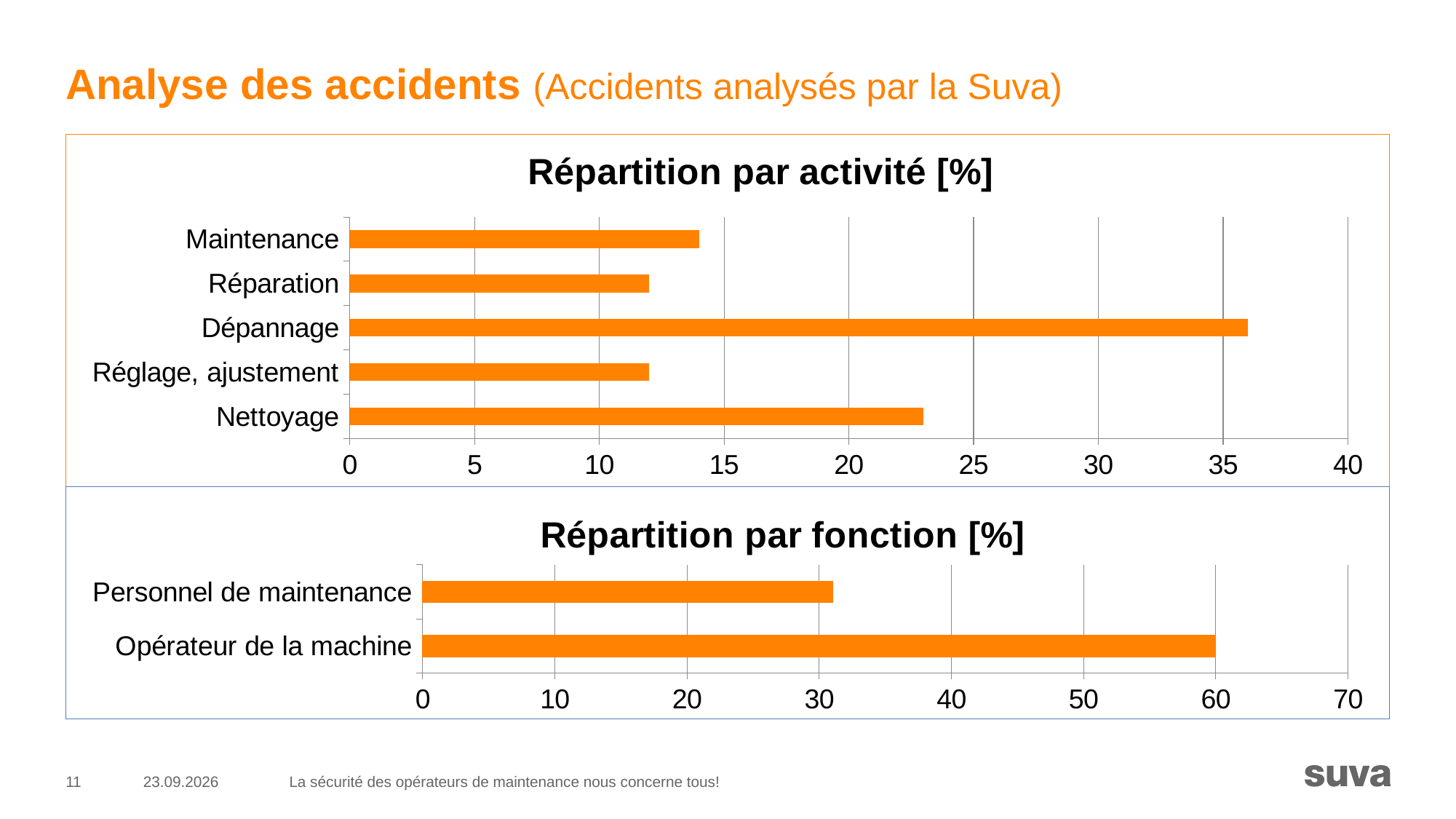
In the chart titled 'Répartition par fonction [%]', is the value for Personnel de maintenance greater or less than 30? greater In the chart titled 'Répartition par fonction [%]', how many categories are shown? 2 In the chart titled 'Répartition par fonction [%]', which function has the highest value? Opérateur de la machine In the chart titled 'Répartition par activité [%]', which activity has the highest value? Dépannage In the chart titled 'Répartition par fonction [%]', is the value for Opérateur de la machine greater or less than 50? greater In the chart titled 'Répartition par activité [%]', which is larger, Nettoyage or Maintenance? Nettoyage In the chart titled 'Répartition par activité [%]', is the value for Maintenance greater or less than 15? less What kind of chart is 'Répartition par activité [%]'? bar chart In the chart titled 'Répartition par activité [%]', how many activity categories are shown? 5 What is the maximum value shown on the x axis of the chart titled 'Répartition par fonction [%]'? 70